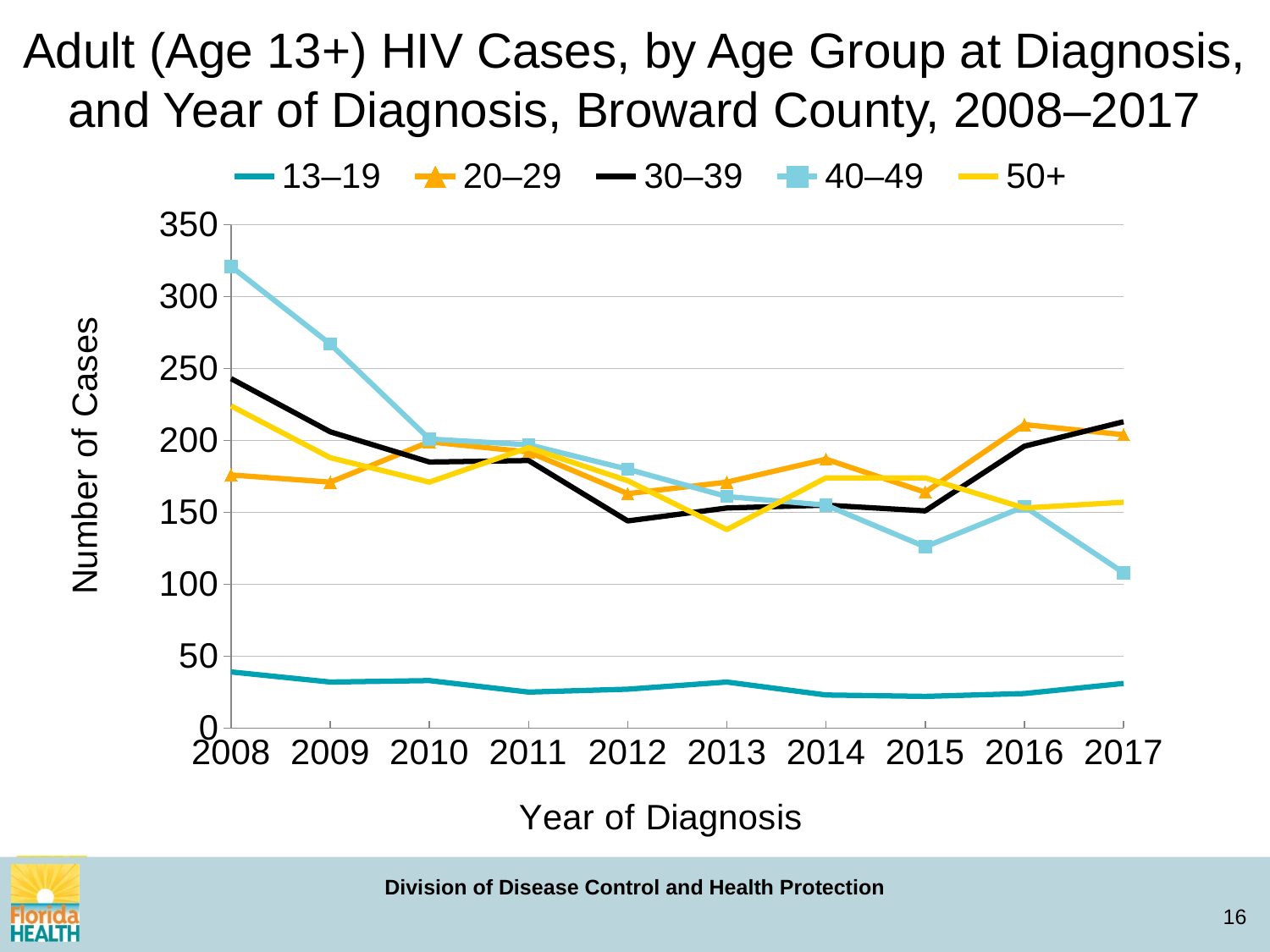
In 2017, which had more cases: the 40–49 age group or the 50+ age group? 50+ What kind of chart is shown on the slide? line chart How many age-group series does the legend list? 5 Which age group had the lowest number of cases in 2017? 13–19 How many years of diagnosis are plotted along the x axis? 10 Is the value for the 30–39 age group in 2008 greater or less than 200? greater Did the number of cases for the 40–49 age group rise or fall from 2008 to 2017? fall Is the value for the 40–49 age group in 2017 greater or less than 150? less Is the value for the 40–49 age group in 2008 greater or less than 300? greater Which age group had the highest number of cases in 2008? 40–49 What is the title of the x axis? Year of Diagnosis